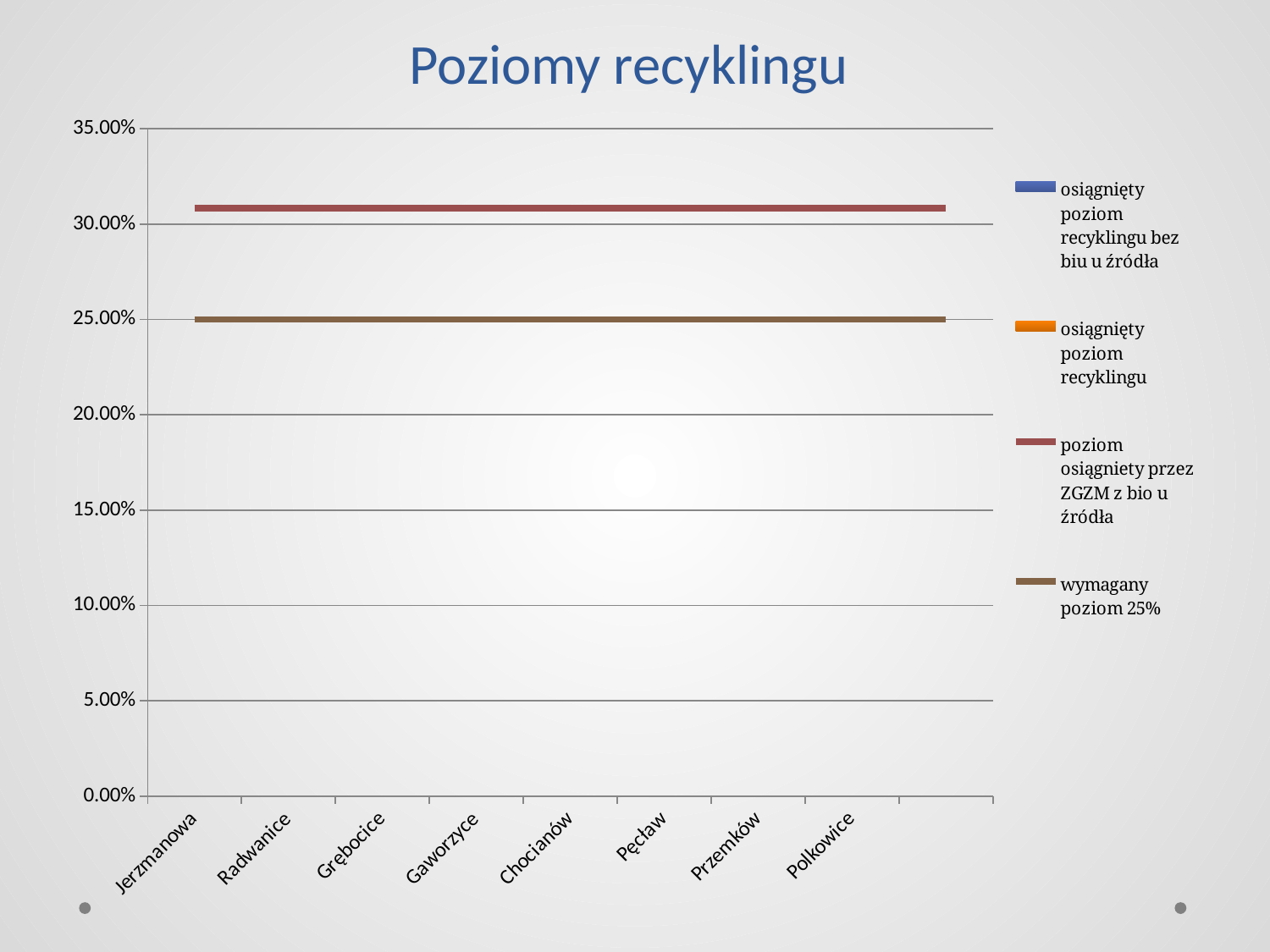
How many labelled categories are on the x axis? 8 Which line is higher: 'poziom osiągniety przez ZGZM z bio u źródła' or 'wymagany poziom 25%'? poziom osiągniety przez ZGZM z bio u źródła What is the title of the chart? Poziomy recyklingu What value does the 'wymagany poziom 25%' line sit at? 25.00% What colour is the 'wymagany poziom 25%' line? brown What kind of chart is shown on the slide? line chart Is the value of the 'poziom osiągniety przez ZGZM z bio u źródła' line greater or less than 30.00%? greater Does the 'poziom osiągniety przez ZGZM z bio u źródła' line rise, fall, or stay flat across the categories? stays flat Does the 'wymagany poziom 25%' line rise, fall, or stay flat across the categories? stays flat What is the first category label on the x axis? Jerzmanowa How many series does the legend list? 4 Is the value of the 'poziom osiągniety przez ZGZM z bio u źródła' line greater or less than 35.00%? less